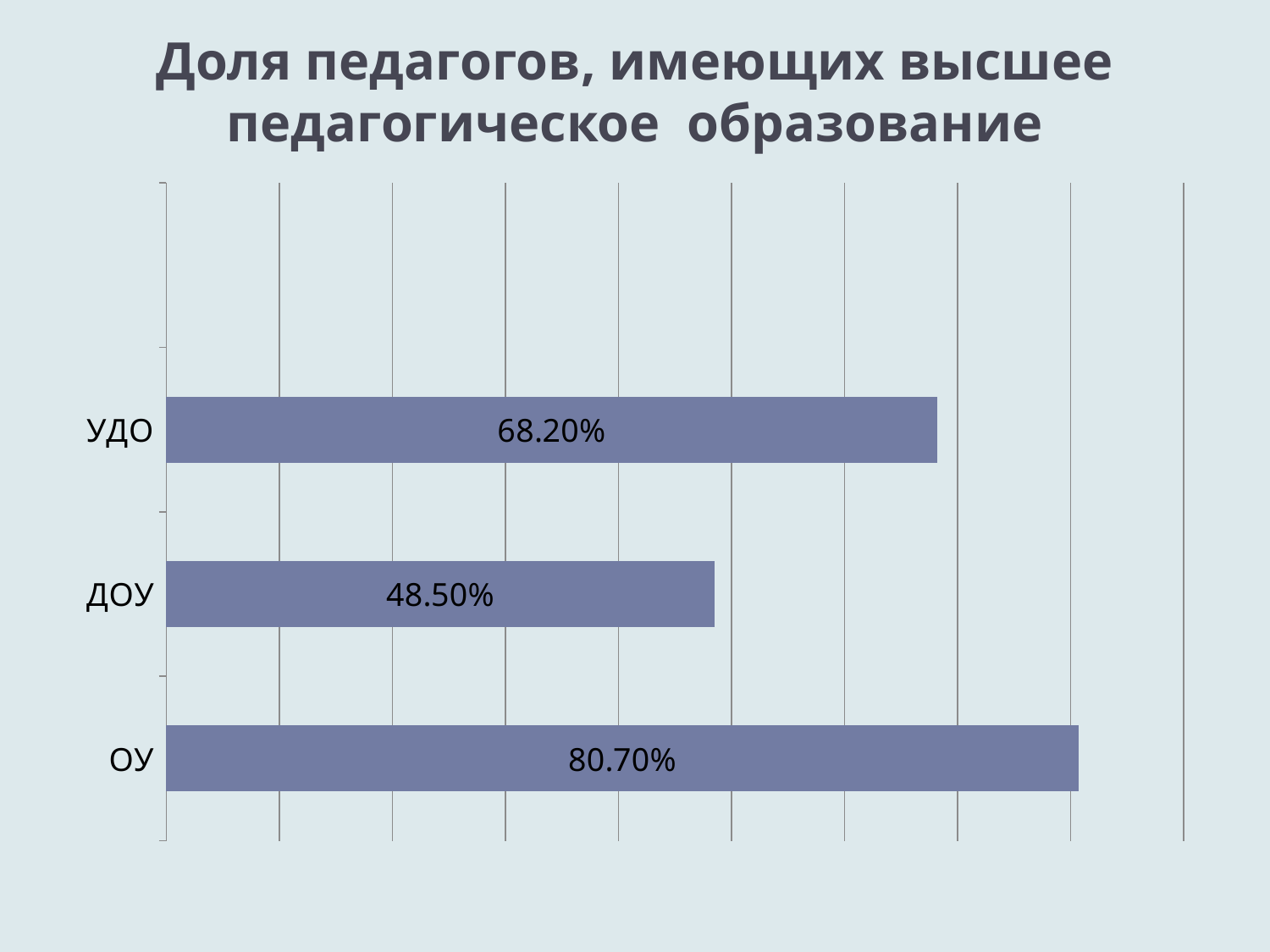
What is the value for УДО? 68.20% Which category has the highest value? ОУ What is the difference between the values for ОУ and УДО? 12.50% How many categories are shown in the chart? 3 What is the title of the chart? Доля педагогов, имеющих высшее педагогическое образование What is the difference between the values for ОУ and ДОУ? 32.20% What is the value for ДОУ? 48.50% What kind of chart is shown on the slide? Bar chart Which is larger, the value for УДО or the value for ДОУ? УДО Which category has the lowest value? ДОУ What is the difference between the values for УДО and ДОУ? 19.70% What is the value for ОУ? 80.70%